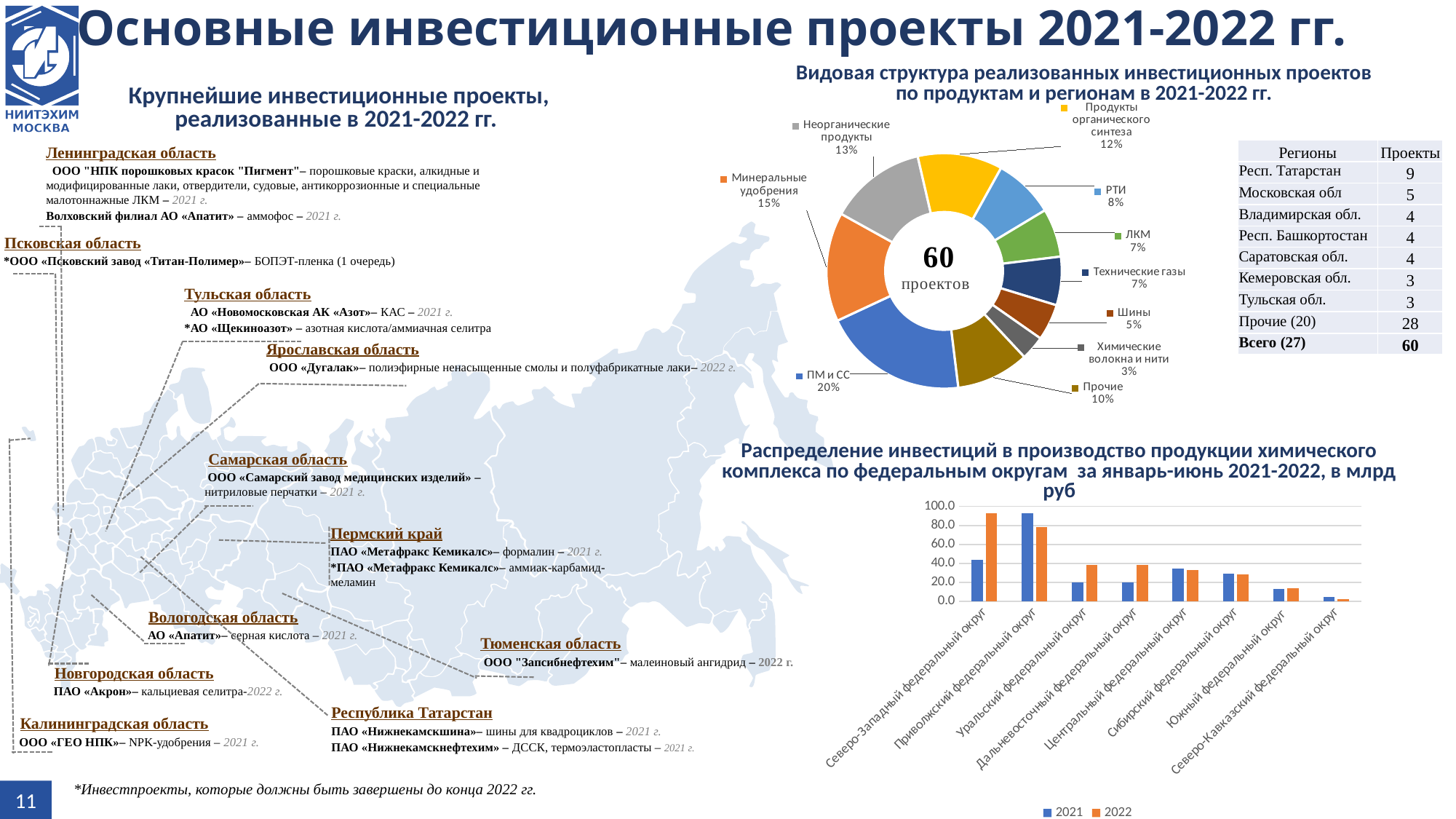
In the donut chart on the structure of investment projects, which product category has the largest share? ПМ и СС In the donut chart on the structure of investment projects, how many percentage points larger is the share of ПМ и СС than the share of Химические волокна и нити? 17 In the bar chart on investments by federal district, is the 2021 value for Приволжский федеральный округ greater or less than 80.0? greater What type of chart is used for the distribution of investments by federal district? bar chart What total number of projects is shown in the centre of the donut chart? 60 проектов In the donut chart on the structure of investment projects, what share do tyres (Шины) account for? 5% In the donut chart on the structure of investment projects, which has the larger share: Неорганические продукты or Продукты органического синтеза? Неорганические продукты How many product categories are shown in the donut chart on the structure of investment projects? 10 How many series does the legend of the bar chart on investments by federal district list? 2 In the bar chart on investments by federal district, which district has the highest value for 2022? Северо-Западный федеральный округ In the donut chart on the structure of investment projects, what share do mineral fertilizers (Минеральные удобрения) account for? 15% In the donut chart on the structure of investment projects, which product category has the smallest share? Химические волокна и нити